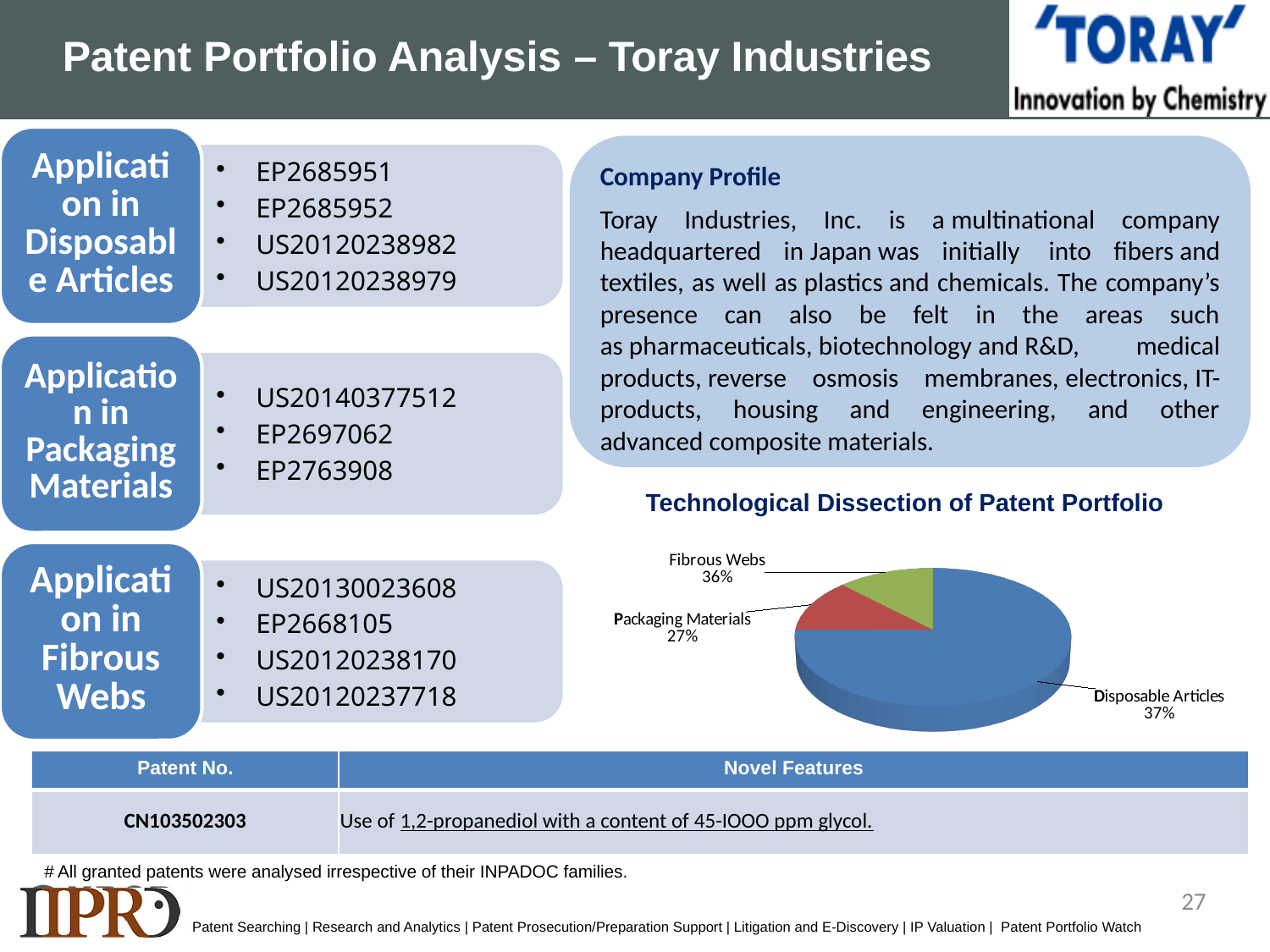
What share of the pie chart is labelled Disposable Articles? 37% How many slices does the pie chart have? 3 What share of the pie chart is labelled Fibrous Webs? 36% What is the title of the pie chart on the slide? Technological Dissection of Patent Portfolio What share of the pie chart is labelled Packaging Materials? 27% Which is larger in the pie chart, Disposable Articles or Packaging Materials? Disposable Articles What type of chart is shown under the heading "Technological Dissection of Patent Portfolio"? Pie chart What is the difference in percentage points between the Disposable Articles share and the Packaging Materials share in the pie chart? 10 Which slice of the pie chart is coloured blue? Disposable Articles Which slice of the pie chart has the largest share? Disposable Articles